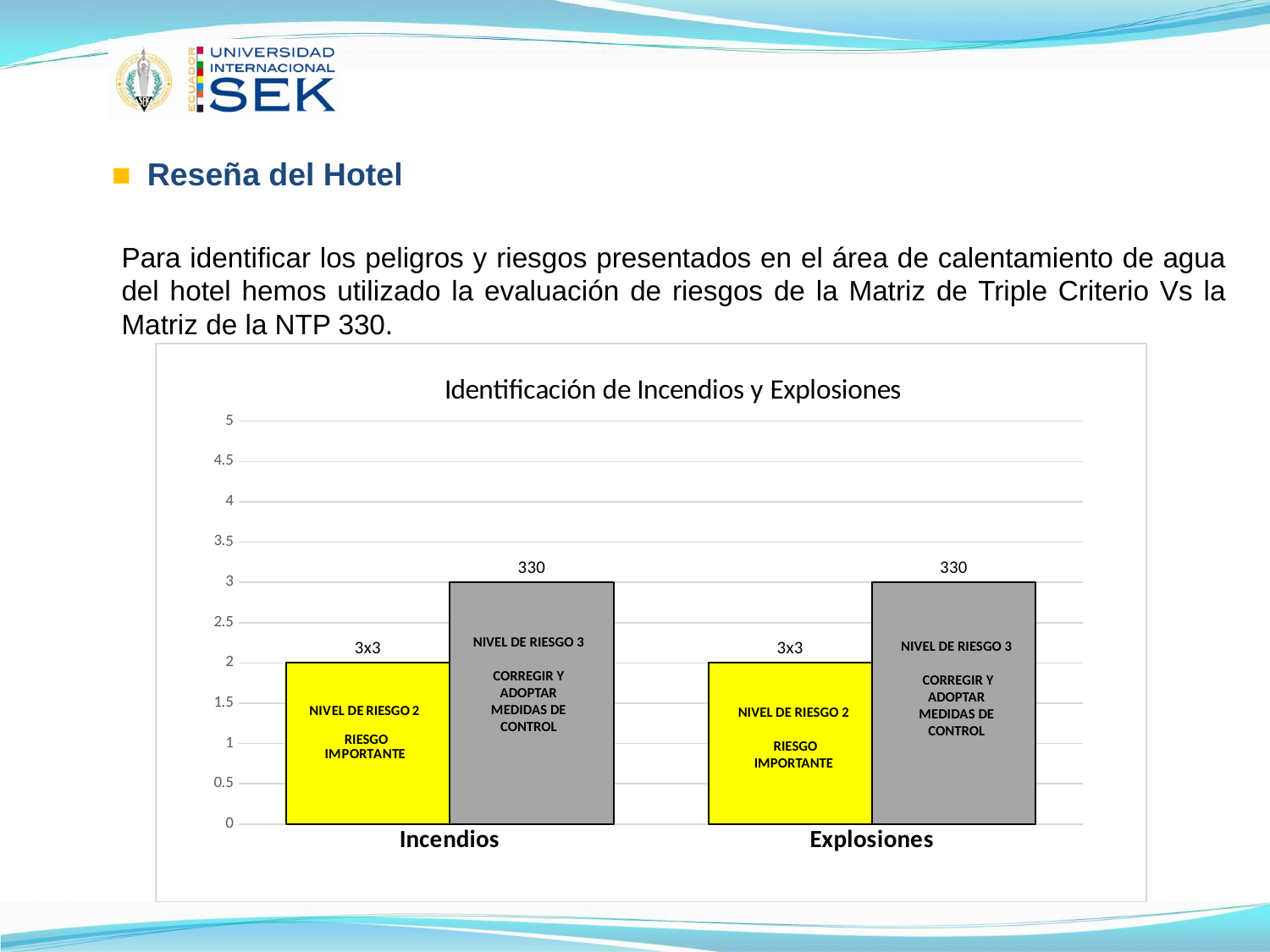
What value on the y axis does the yellow bar for Incendios reach? 2 What is the difference in height between the gray bar and the yellow bar for Explosiones, according to the y axis? 1 What are the two categories on the x axis of the chart? Incendios and Explosiones What is the title of the chart? Identificación de Incendios y Explosiones Which bar is taller for Incendios, the yellow bar or the gray bar? the gray bar What value on the y axis does the gray bar for Explosiones reach? 3 What is the data label printed above the yellow bar for Incendios? 3x3 How many categories are shown on the x axis of the chart? 2 What is the data label printed above the gray bar for Explosiones? 330 What text is written inside the yellow bars? NIVEL DE RIESGO 2 RIESGO IMPORTANTE What type of chart is shown on the slide? bar chart Is the height of the gray bar for Incendios greater or less than 2.5 on the y axis? greater